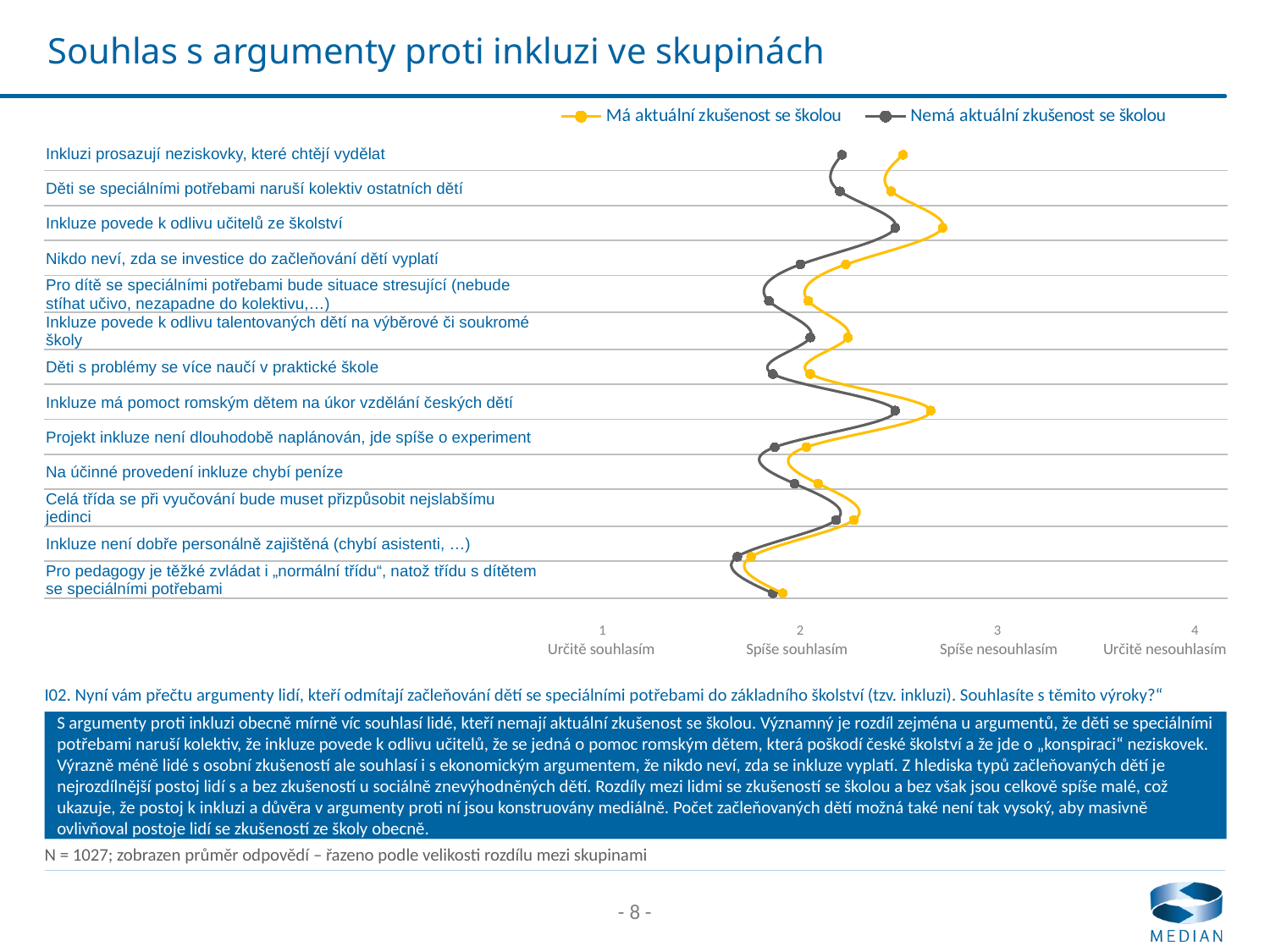
Is the value for "Inkluze má pomoct romským dětem na úkor vzdělání českých dětí" in the series "Má aktuální zkušenost se školou" greater or less than 3? less Is the value for "Inkluze není dobře personálně zajištěná (chybí asistenti, …)" in the series "Nemá aktuální zkušenost se školou" greater or less than 2? less Is the value for "Děti s problémy se více naučí v praktické škole" in the series "Nemá aktuální zkušenost se školou" greater or less than 2? less How many argument statements (categories) are plotted on the chart? 13 Which category has the lowest value in the series "Nemá aktuální zkušenost se školou"? Inkluze není dobře personálně zajištěná (chybí asistenti, …) For "Inkluze povede k odlivu učitelů ze školství", which series has the larger value? Má aktuální zkušenost se školou For "Inkluzi prosazují neziskovky, které chtějí vydělat", which series has the larger value? Má aktuální zkušenost se školou How many series does the legend list? 2 What kind of chart is shown on the slide? line chart What label does the x axis show at the value 1? Určitě souhlasím